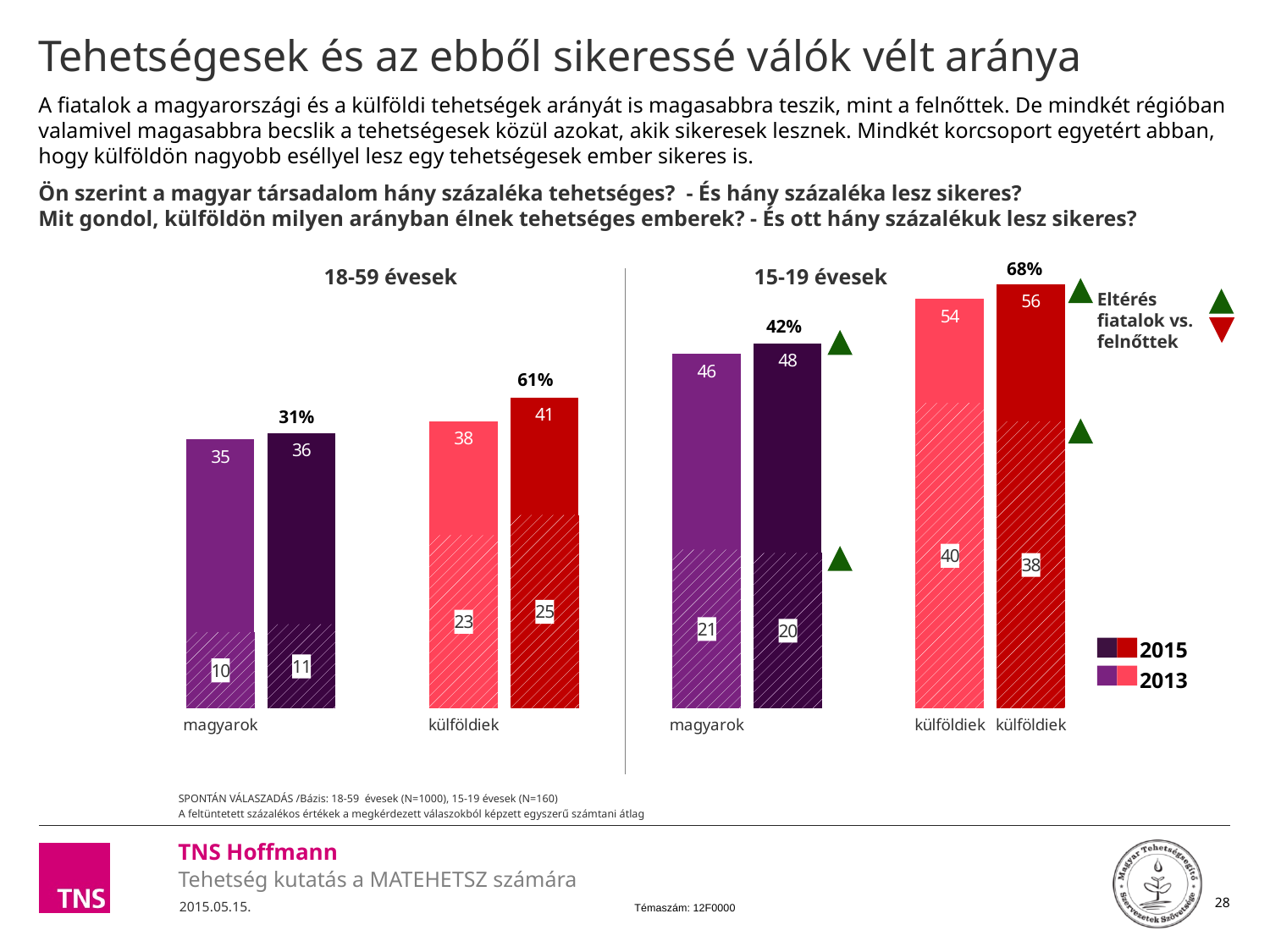
In the '15-19 évesek' chart, which has the higher top value for 2015: magyarok or külföldiek? külföldiek In the '15-19 évesek' chart, what value is printed at the top of the 2015 bar for külföldiek? 56 In the '18-59 évesek' chart, what is the difference between the top values of the 2015 bars for külföldiek and magyarok? 5 In the '18-59 évesek' chart, what value is printed at the top of the 2015 bar for magyarok? 36 In the '15-19 évesek' chart, what percentage label is shown above the külföldiek bars? 68% Which year does the legend associate with the darker colours? 2015 How many series does the legend list? 2 In the '18-59 évesek' chart, what value is printed in the hatched lower section of the 2015 bar for külföldiek? 25 What kind of chart is used on this slide? bar chart In the '18-59 évesek' chart, what value is printed at the top of the 2013 bar for külföldiek? 38 In the '18-59 évesek' chart, what percentage label is shown above the magyarok bars? 31% In the '15-19 évesek' chart, what value is printed in the hatched lower section of the 2013 bar for magyarok? 21